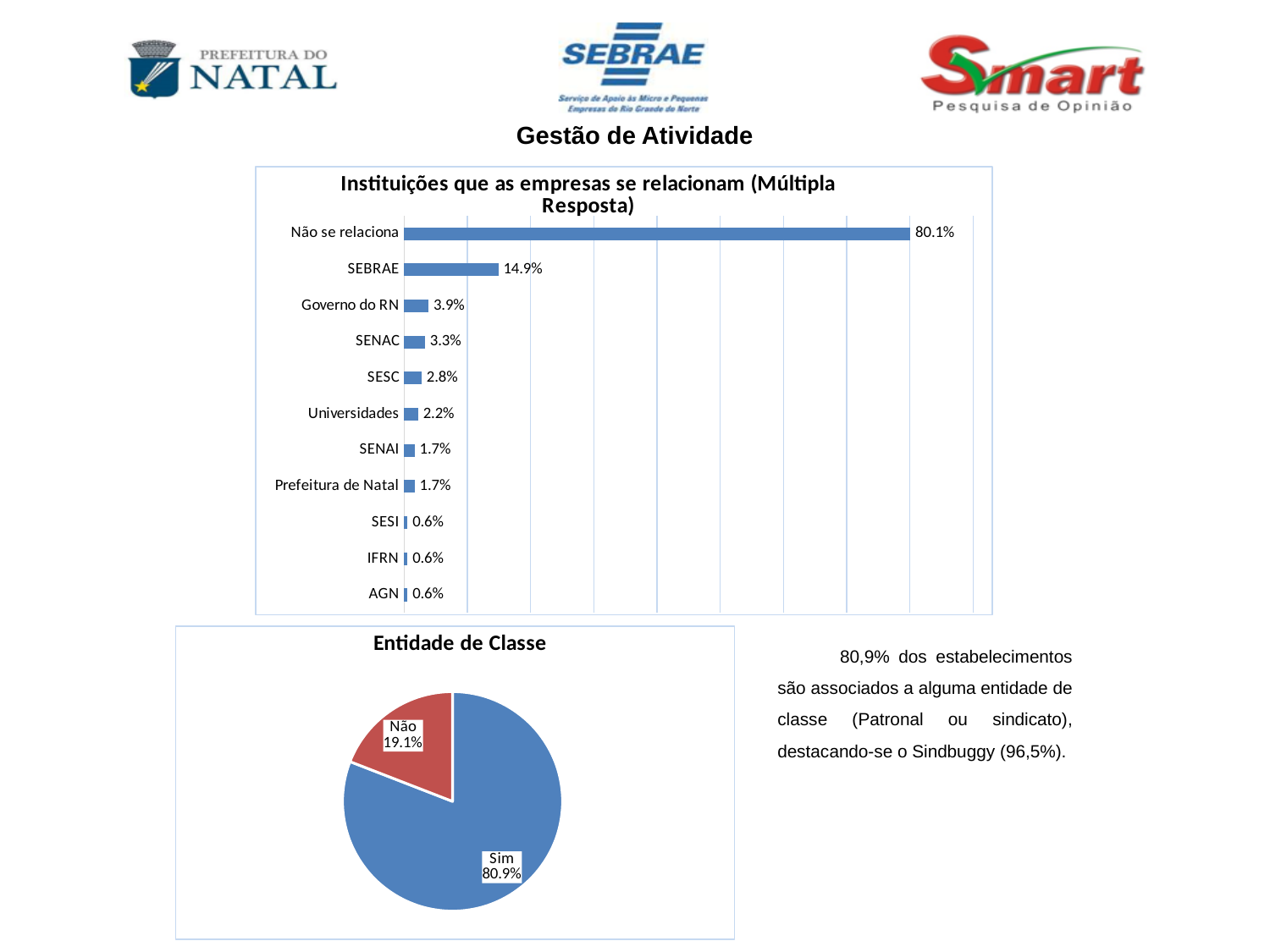
In the 'Instituições que as empresas se relacionam (Múltipla Resposta)' chart, what is the value for SEBRAE? 14.9% How many categories are shown in the 'Instituições que as empresas se relacionam (Múltipla Resposta)' chart? 11 What kind of chart is the 'Entidade de Classe' chart? Pie chart In the 'Entidade de Classe' chart, what share does the 'Sim' slice have? 80.9% In the 'Instituições que as empresas se relacionam (Múltipla Resposta)' chart, which category has the highest value? Não se relaciona In the 'Instituições que as empresas se relacionam (Múltipla Resposta)' chart, what is the value for Governo do RN? 3.9% In the 'Entidade de Classe' chart, what colour is the 'Não' slice? Red In the 'Instituições que as empresas se relacionam (Múltipla Resposta)' chart, what is the value for Universidades? 2.2% What kind of chart is the 'Instituições que as empresas se relacionam (Múltipla Resposta)' chart? Bar chart In the 'Instituições que as empresas se relacionam (Múltipla Resposta)' chart, what is the difference between the values for Não se relaciona and SEBRAE? 65.2% In the 'Entidade de Classe' chart, what is the value for 'Não'? 19.1% In the 'Instituições que as empresas se relacionam (Múltipla Resposta)' chart, which is larger, the value for SENAC or the value for SESC? SENAC